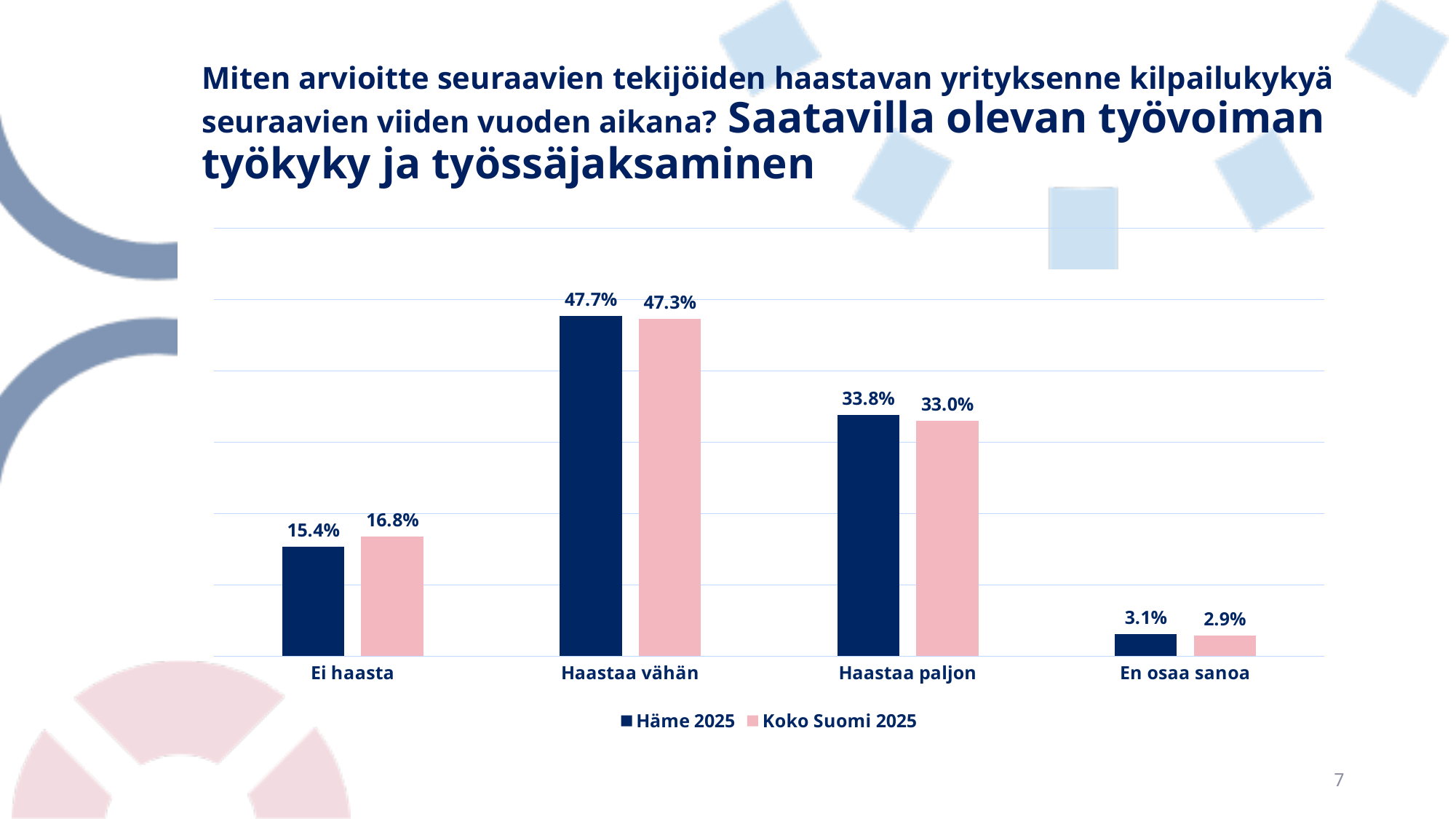
Which series is shown in pink in the legend? Koko Suomi 2025 What is the value for Koko Suomi 2025 in the 'Haastaa paljon' category? 33.0% What is the value for Häme 2025 in the 'En osaa sanoa' category? 3.1% In the 'Ei haasta' category, which series has the larger value, Häme 2025 or Koko Suomi 2025? Koko Suomi 2025 How many categories are shown on the x axis? 4 Which category has the highest value for Häme 2025? Haastaa vähän What is the value for Koko Suomi 2025 in the 'Ei haasta' category? 16.8% Which category has the lowest value for Koko Suomi 2025? En osaa sanoa How many series does the legend list? 2 What is the difference between Häme 2025 and Koko Suomi 2025 in the 'Haastaa paljon' category? 0.8% What kind of chart is shown on the slide? Bar chart What is the value for Häme 2025 in the 'Haastaa vähän' category? 47.7%